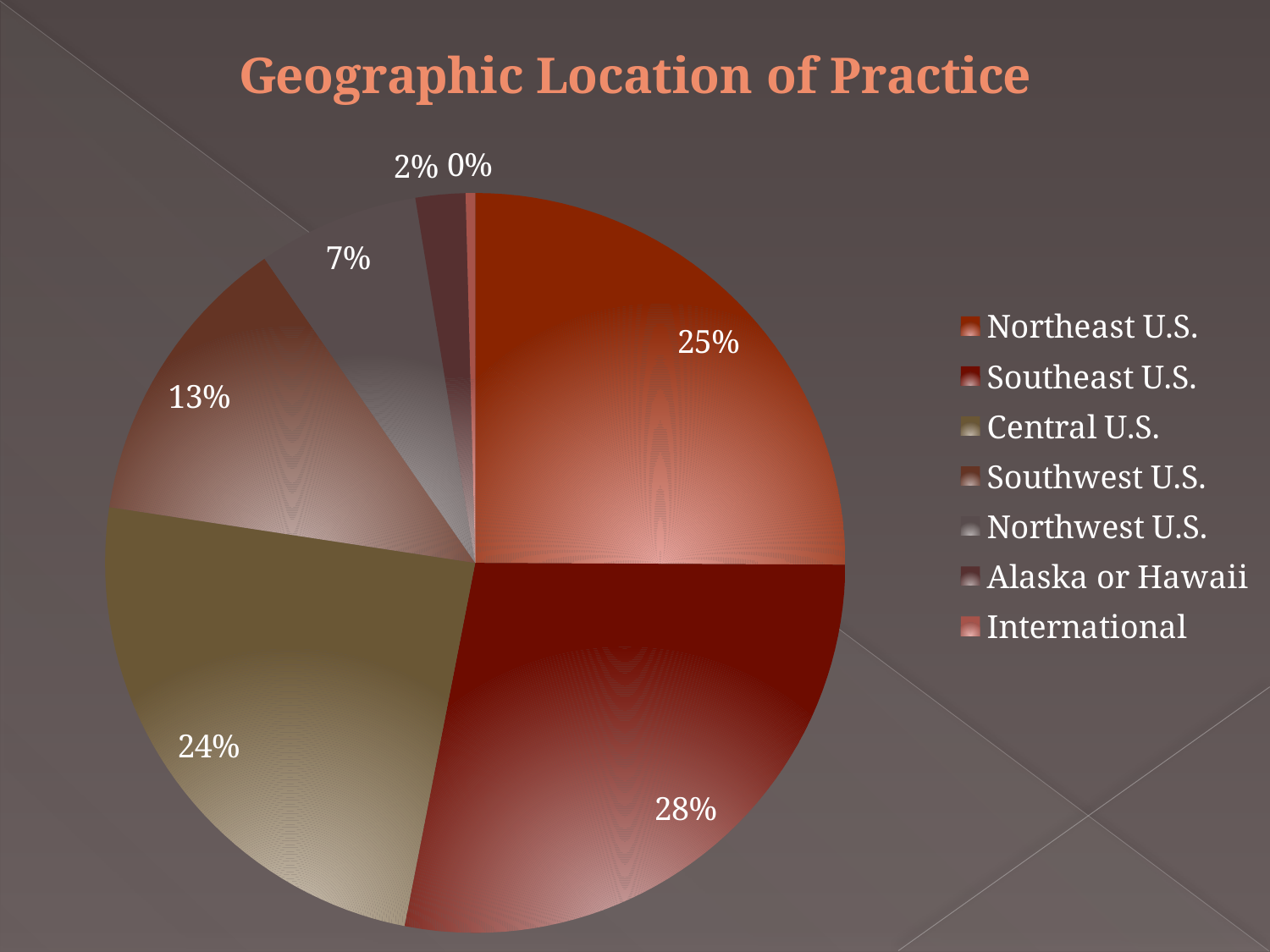
Which region has the smallest share of the pie? International What percentage of the pie is Southwest U.S.? 13% What is the difference in percentage points between Southeast U.S. and Central U.S.? 4 What type of chart is shown on the slide? pie chart How many categories does the legend list? 7 What percentage of the pie is Northwest U.S.? 7% What percentage of the pie is Central U.S.? 24% What percentage of the pie is Northeast U.S.? 25% Which is larger, the share for Southwest U.S. or the share for Northwest U.S.? Southwest U.S. What is the title of the chart? Geographic Location of Practice What percentage of the pie is Southeast U.S.? 28% Which region has the largest share of the pie? Southeast U.S.